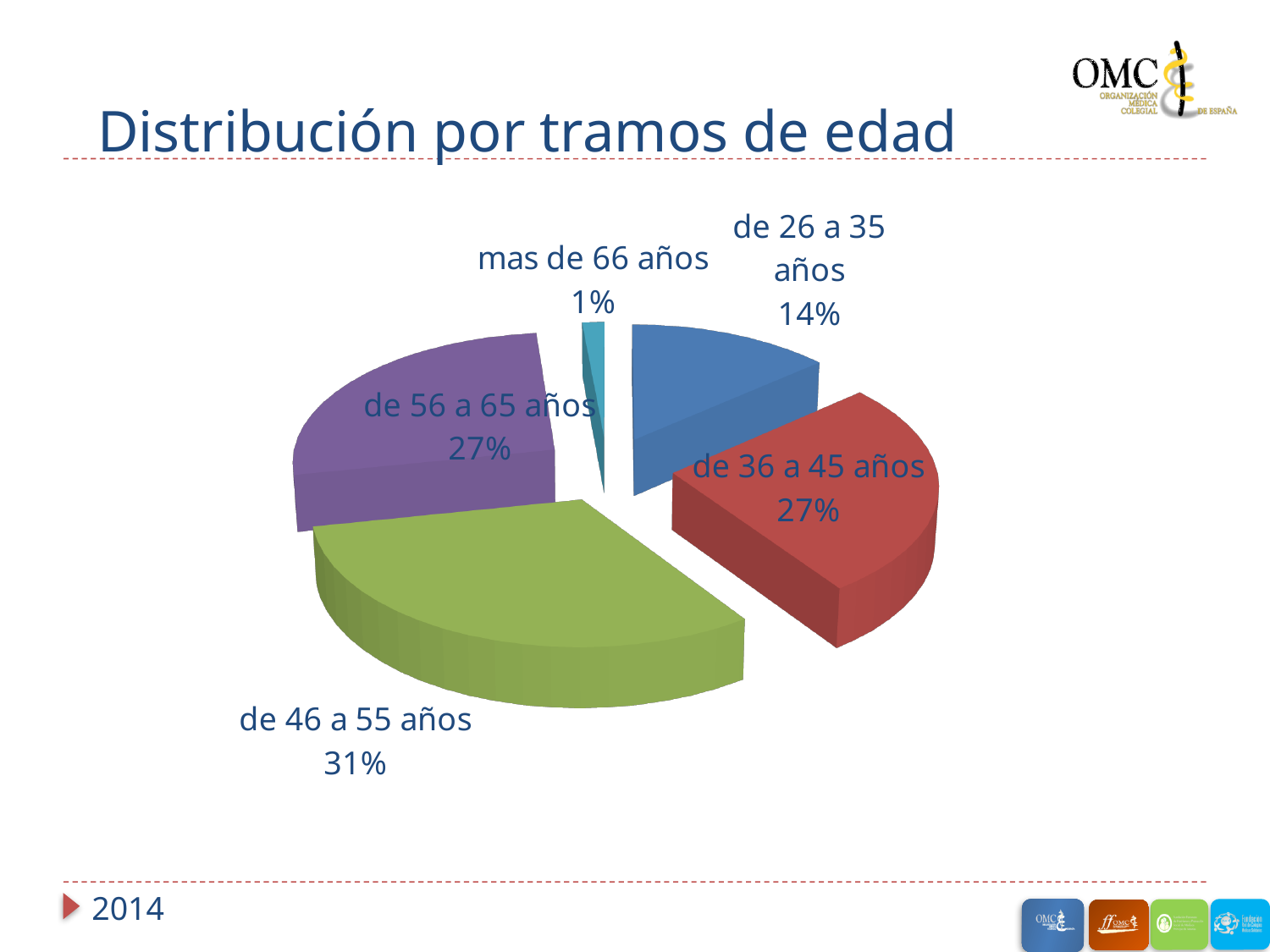
What kind of chart is shown on the slide? pie chart Which is larger, the share for 'de 36 a 45 años' or the share for 'de 26 a 35 años'? de 36 a 45 años What is the difference between the shares of 'de 46 a 55 años' and 'de 26 a 35 años'? 17% Which age group has the largest share of the pie? de 46 a 55 años What is the value shown for 'mas de 66 años'? 1% What share of the pie does the 'de 46 a 55 años' slice represent? 31% What is the value shown for 'de 56 a 65 años'? 27% What colour is the 'de 46 a 55 años' slice? green What is the value shown for 'de 26 a 35 años'? 14% What is the title of the slide containing the chart? Distribución por tramos de edad Which age group has the smallest share of the pie? mas de 66 años How many slices does the pie chart have? 5